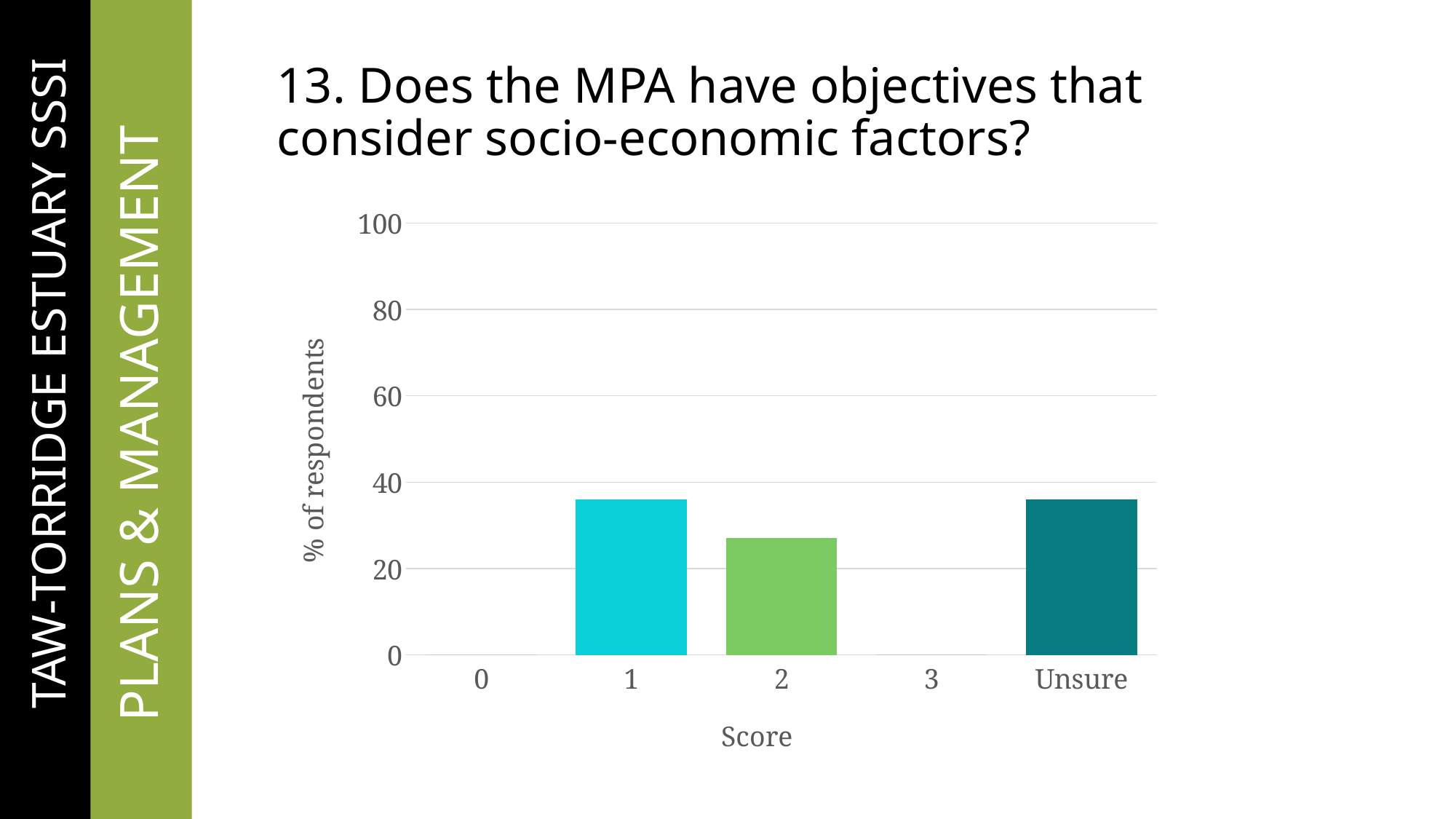
Is the value for score 2 greater or less than 20? greater Which has the larger value, score 1 or score 2? score 1 Is the value for Unsure greater or less than 20? greater How many score categories are shown on the x axis of the chart? 5 Which has the larger value, Unsure or score 2? Unsure Is the value for Unsure greater or less than 40? less What is the label of the y axis of the chart? % of respondents What is the label of the x axis of the chart? Score What kind of chart is shown on the slide? bar chart